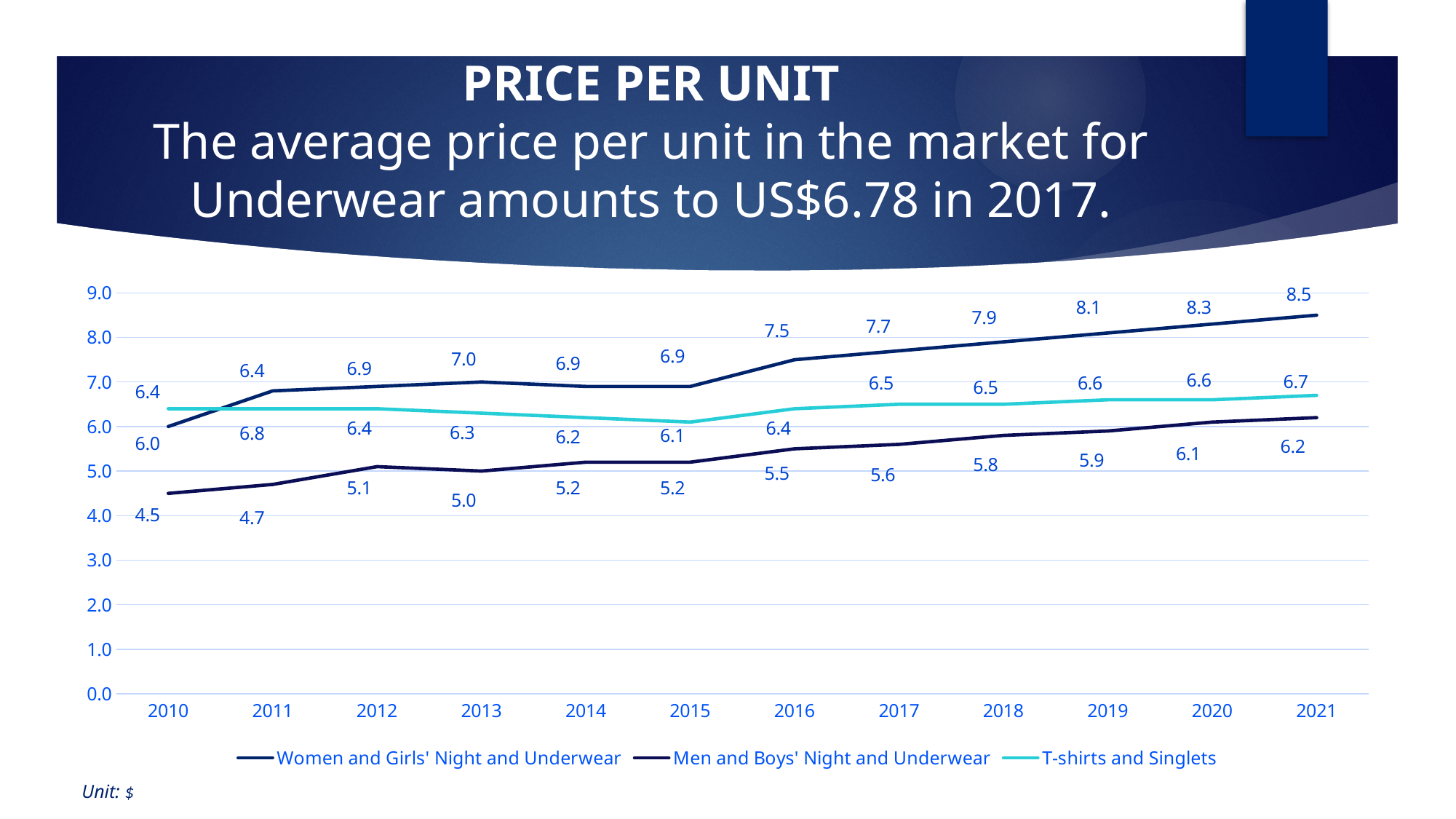
What kind of chart is shown on the slide? line chart What is the value for Women and Girls' Night and Underwear in 2021? 8.5 What is the difference between Women and Girls' Night and Underwear and Men and Boys' Night and Underwear in 2021? 2.3 What is the value for T-shirts and Singlets in 2017? 6.5 In 2015, which is larger: T-shirts and Singlets or Men and Boys' Night and Underwear? T-shirts and Singlets What is the value for Men and Boys' Night and Underwear in 2010? 4.5 Does the value for Women and Girls' Night and Underwear rise or fall from 2016 to 2021? rise In which year is the value for T-shirts and Singlets lowest? 2015 How many years are shown on the x axis? 12 Is the value for Men and Boys' Night and Underwear in 2021 greater or less than 7.0? less How many series does the legend list? 3 Which series has the highest value in 2021? Women and Girls' Night and Underwear